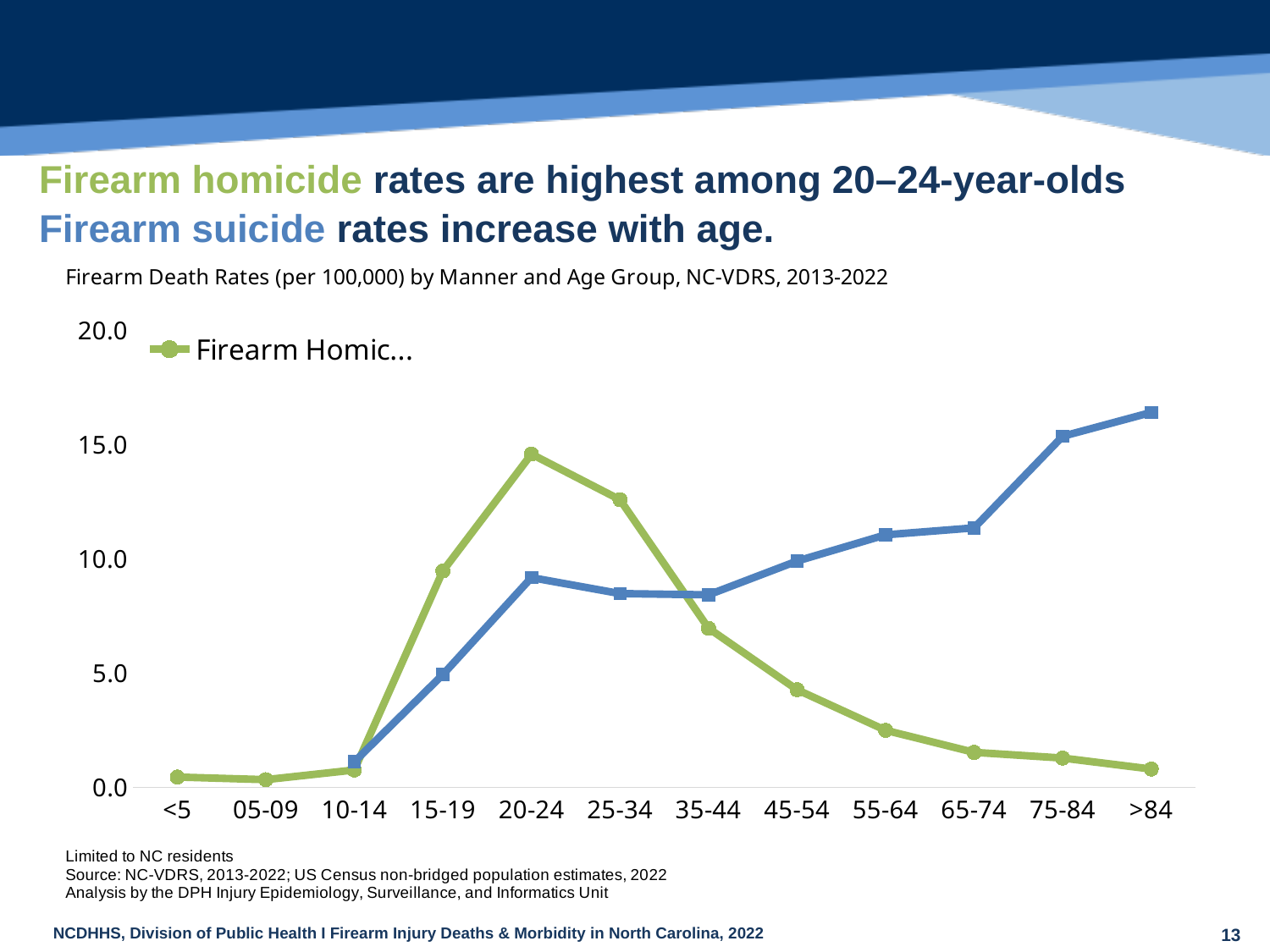
In which age group is the Firearm Suicide (blue) line at its lowest value? 10-14 Is the Firearm Homicide rate for the 20-24 age group greater or less than 10.0? greater In which age group does the Firearm Suicide (blue) line reach its highest value? >84 For the 20-24 age group, which line is higher: Firearm Homicide or Firearm Suicide? Firearm Homicide Is the Firearm Suicide (blue) rate for the 20-24 age group greater or less than 10.0? less How many age groups are shown on the x axis? 12 Does the Firearm Homicide line rise or fall from the 20-24 age group to the >84 age group? Fall In which age group does the Firearm Homicide line reach its highest value? 20-24 What kind of chart is shown on the slide? Line chart Is the Firearm Homicide rate for the 45-54 age group greater or less than 5.0? less For the 45-54 age group, which line is higher: Firearm Homicide or Firearm Suicide? Firearm Suicide